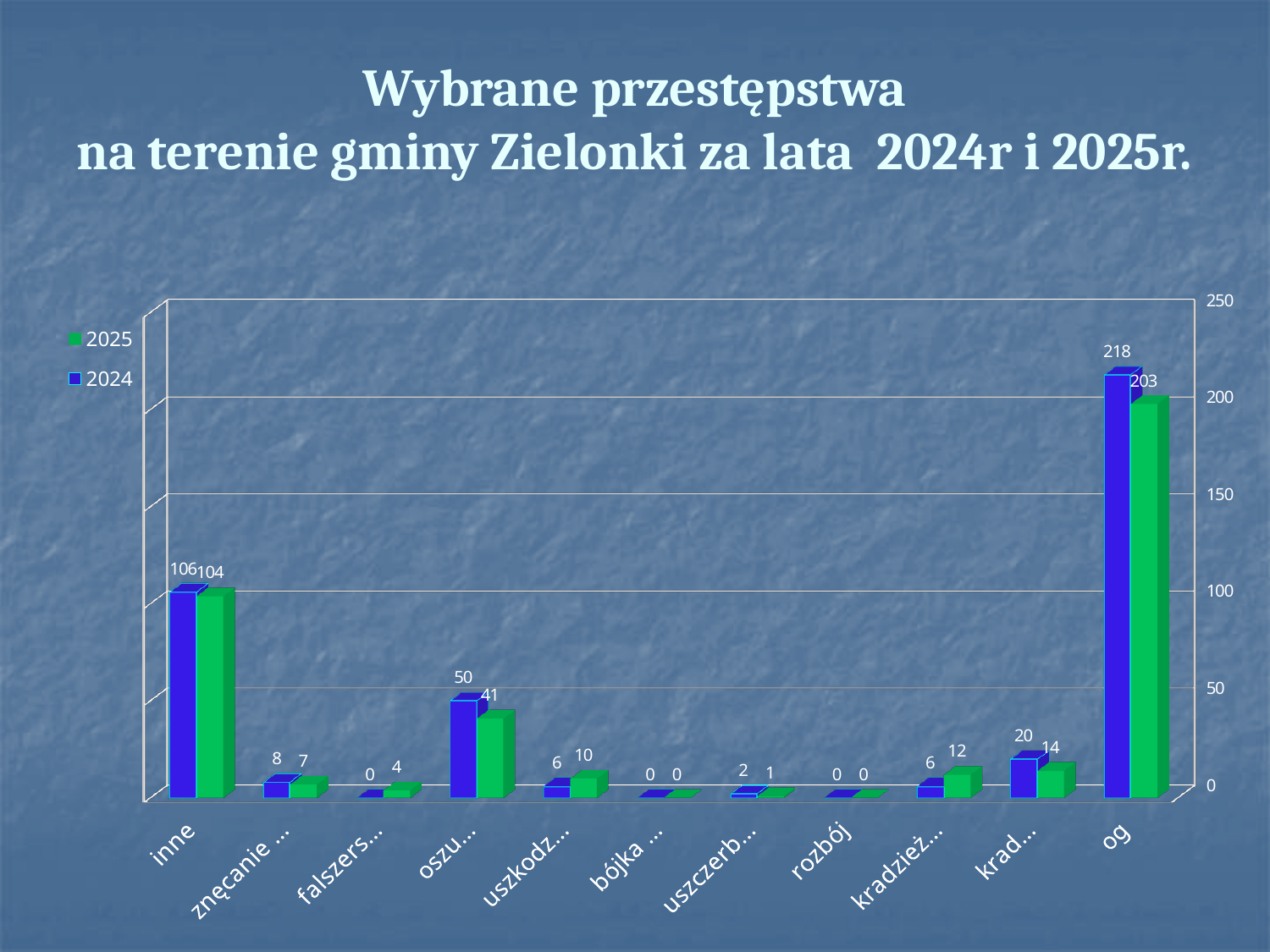
What is the difference between the 2024 and 2025 values for the category 'inne'? 2 What is the difference between the 2024 and 2025 values for the category 'og'? 15 Which category has the highest 2024 value? og How many categories are shown on the x axis? 11 Is the 2024 value for the category 'og' greater or less than 200? greater What kind of chart is shown on the slide? bar chart What is the 2025 value for the category labelled 'oszu...'? 41 What is the 2024 value for the category 'rozbój'? 0 For the category labelled 'oszu...', which year has the larger value, 2024 or 2025? 2024 What is the 2025 value for the category 'og'? 203 What is the 2024 value for the category 'inne'? 106 How many series does the legend list? 2